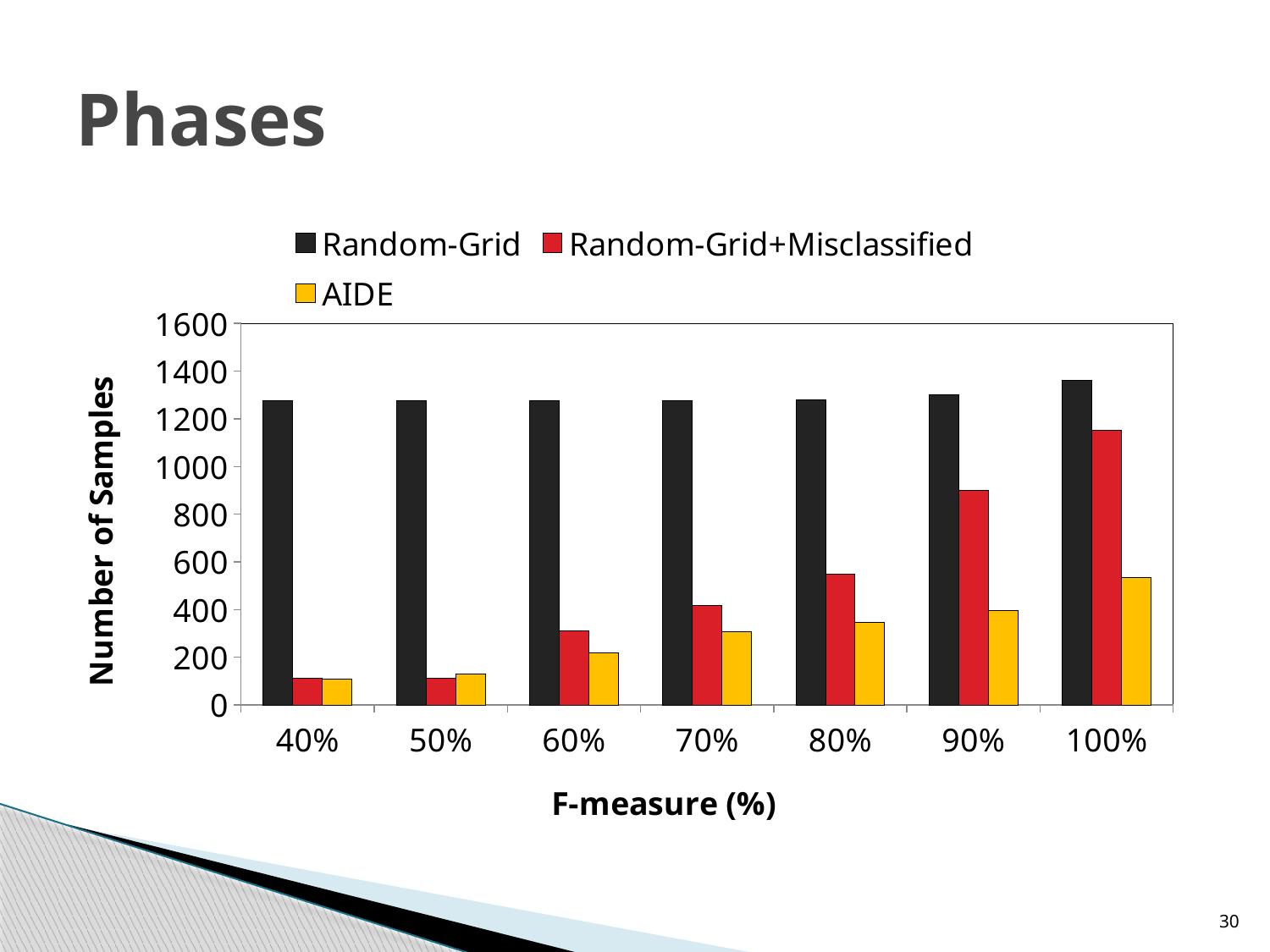
At which F-measure is the Random-Grid+Misclassified value highest? 100% What is the title of the y axis? Number of Samples Is the value for AIDE at 100% greater or less than 600? less Do the Random-Grid+Misclassified values rise or fall as the F-measure increases along the x axis? rise Is the value for Random-Grid+Misclassified at 90% greater or less than 800? greater Is the value for AIDE at 80% greater or less than 400? less At 60%, which is larger: Random-Grid+Misclassified or AIDE? Random-Grid+Misclassified What kind of chart is shown on the slide? bar chart How many series does the legend list? 3 At 100%, which is larger: Random-Grid or Random-Grid+Misclassified? Random-Grid How many F-measure categories are shown on the x axis? 7